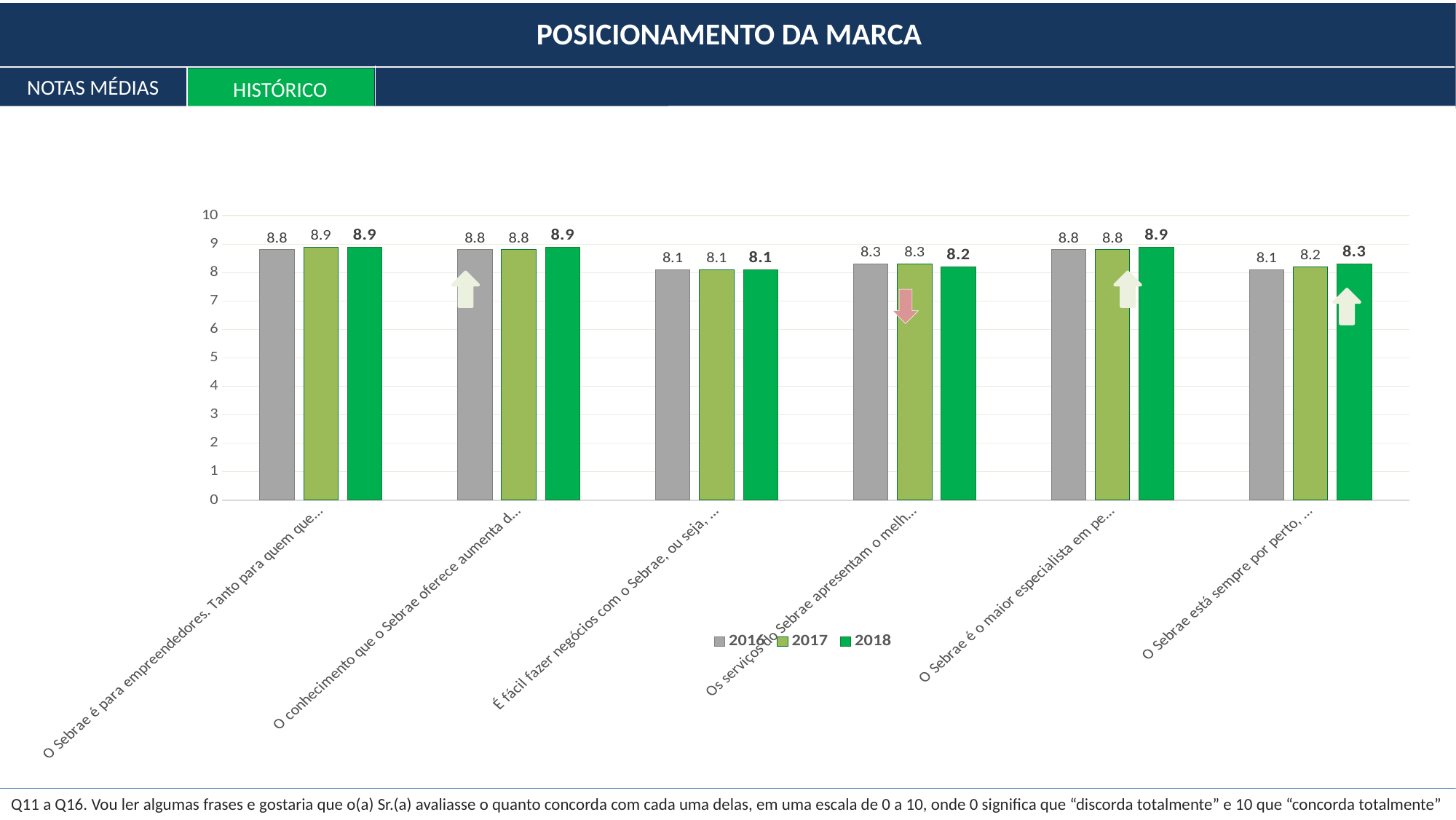
Which statement has the lowest 2018 value? É fácil fazer negócios com o Sebrae, ou seja, ... How many series does the legend list? 3 What is the 2018 value for the statement beginning "O Sebrae está sempre por perto"? 8.3 Which legend entry is shown in grey? 2016 What is the 2016 value for the statement beginning "É fácil fazer negócios com o Sebrae"? 8.1 What is the 2017 value for the statement beginning "O Sebrae é para empreendedores"? 8.9 What is the 2018 value for the statement beginning "Os serviços do Sebrae apresentam o melh..."? 8.2 What type of chart is shown on the slide? bar chart Is the 2016 value for the statement beginning "O conhecimento que o Sebrae oferece" greater or less than 8? greater How many categories (statements) are shown on the x axis? 6 Which is larger: the 2018 value for "O Sebrae é o maior especialista em pe..." or the 2018 value for "Os serviços do Sebrae apresentam o melh..."? O Sebrae é o maior especialista em pe... What is the difference between the 2018 and 2016 values for the statement beginning "O Sebrae está sempre por perto"? 0.2